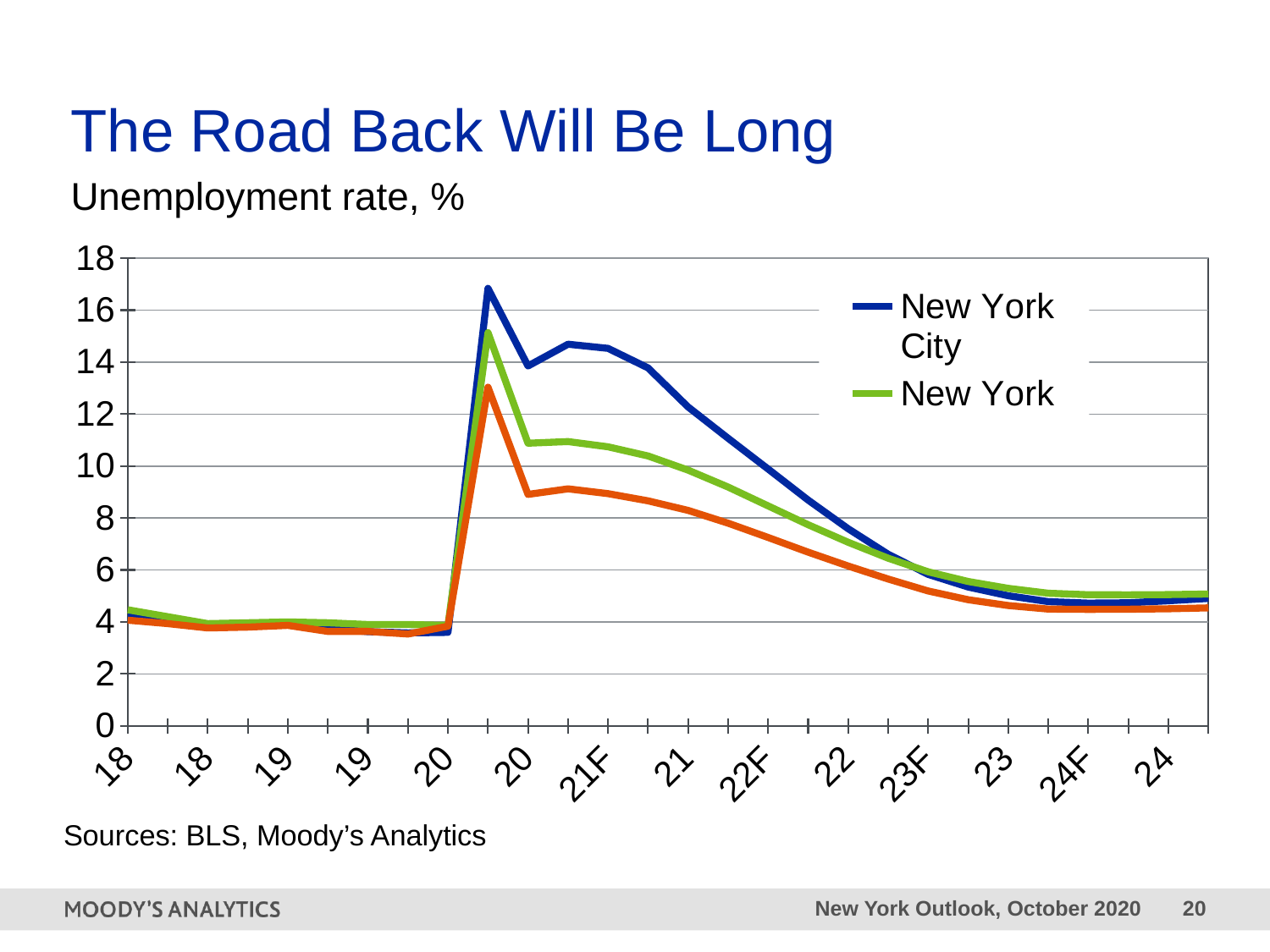
Is the value for New York City at 24 greater or less than 6? less Is the peak value for New York greater or less than 14? greater Do the values for New York City rise or fall from 21F to 24? fall What quantity does the chart plot, according to the subtitle? Unemployment rate, % Is the value for New York at 22 greater or less than 10? less At their peaks in 2020, which series is higher, New York City or New York? New York City What is the title of the slide containing the chart? The Road Back Will Be Long How many labels are shown along the x axis? 14 What kind of chart is shown on the slide? line chart How many series does the chart's legend list? 2